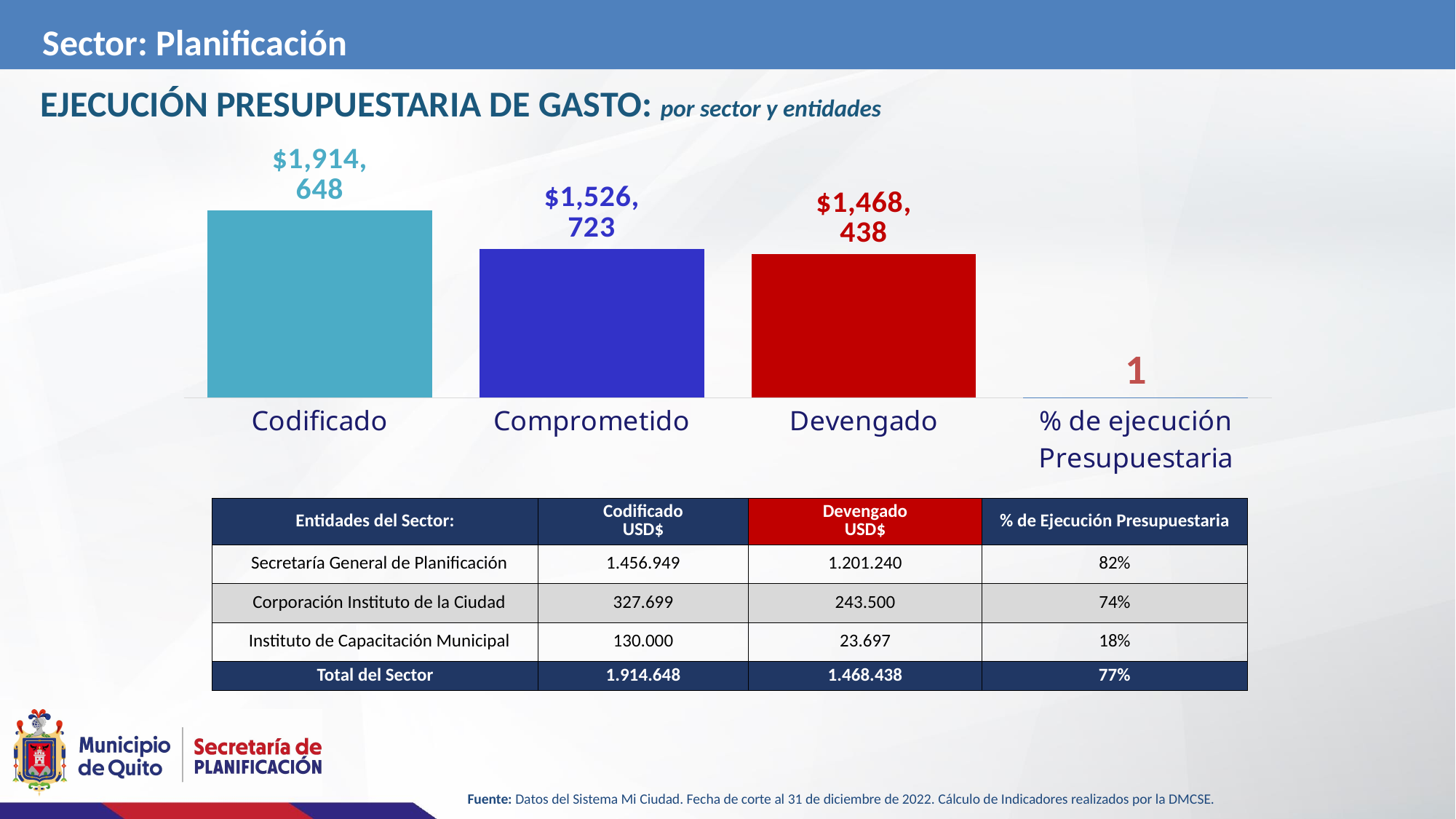
What is the value of the Comprometido bar? $1,526,723 What kind of chart is shown on the slide? Bar chart What is the value of the Devengado bar? $1,468,438 How many categories are shown on the x axis of the chart? 4 What is the difference between the Codificado and Comprometido values? $387,925 What value is shown for the '% de ejecución Presupuestaria' category in the chart? 1 What is the value of the Codificado bar? $1,914,648 Do the bar values rise or fall from left to right across the chart? Fall Which is larger, the Comprometido value or the Devengado value? Comprometido What is the difference between the Comprometido and Devengado values? $58,285 Which category has the highest value in the chart? Codificado Which category has the lowest value in the chart? % de ejecución Presupuestaria